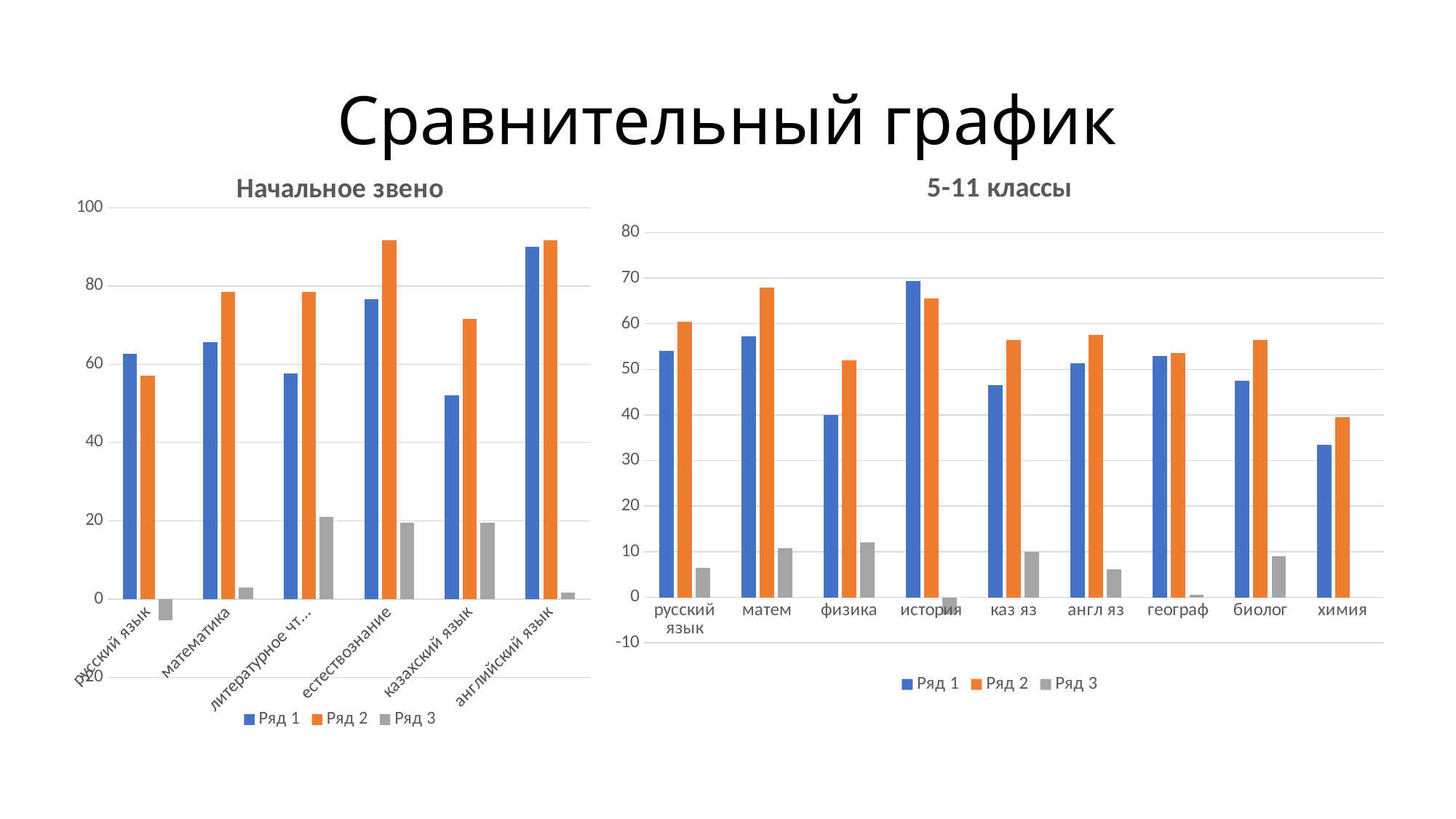
In the '5-11 классы' chart, for история, which is larger: Ряд 1 or Ряд 2? Ряд 1 What kind of chart is the 'Начальное звено' chart? bar chart How many categories are shown on the '5-11 классы' chart? 9 In the 'Начальное звено' chart, is the Ряд 1 value for русский язык greater or less than 60? greater In the '5-11 классы' chart, which category has the highest value for Ряд 1? история In the '5-11 классы' chart, is the Ряд 3 value for физика greater or less than 10? greater In the '5-11 классы' chart, which category has the lowest value for Ряд 3? история In the 'Начальное звено' chart, which category has the highest value for Ряд 1? английский язык How many series does the legend of the 'Начальное звено' chart list? 3 In the 'Начальное звено' chart, which category has the lowest value for Ряд 2? русский язык In the '5-11 классы' chart, which category has the lowest value for Ряд 1? химия In the 'Начальное звено' chart, for математика, which is larger: Ряд 1 or Ряд 2? Ряд 2